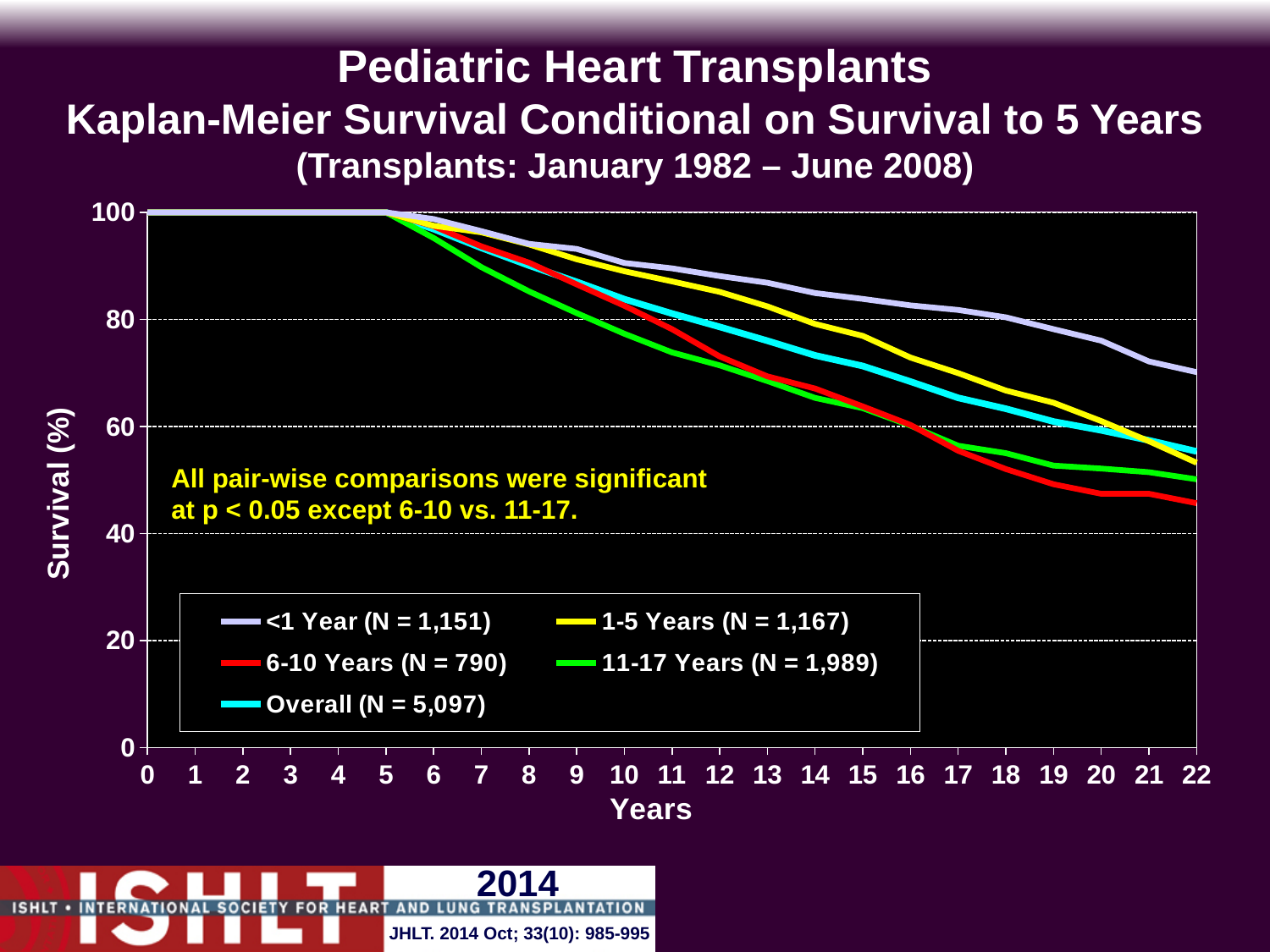
Is the survival value for the <1 Year series at year 22 greater or less than 60? greater Is the survival value for the 11-17 Years series at year 10 greater or less than 80? less Is the survival value for the 6-10 Years series at year 22 greater or less than 60? less What is the N for the 6-10 Years series shown in the legend? 790 Do the survival curves rise or fall as years increase beyond year 5? fall What kind of chart is shown on the slide? line chart At year 10, which series has the higher survival: <1 Year or 11-17 Years? <1 Year Which series has the highest survival at year 22? <1 Year (N = 1,151) How many series does the legend list? 5 Which series has the lowest survival at year 22? 6-10 Years (N = 790) What is the survival value for all series at year 5? 100